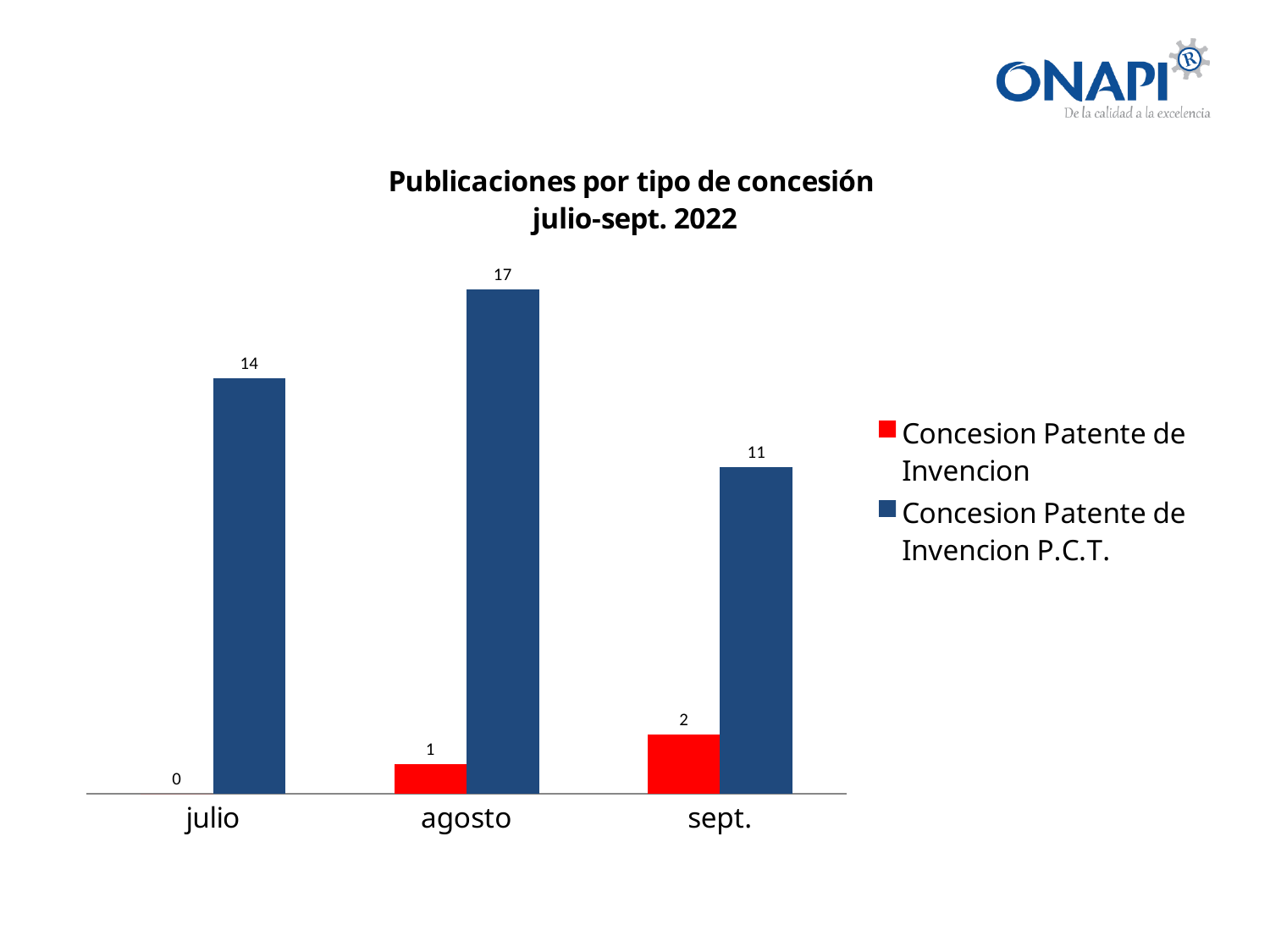
Which month has the lowest value for Concesion Patente de Invencion P.C.T.? sept. What is the difference between the Concesion Patente de Invencion P.C.T. values for agosto and sept.? 6 What colour represents Concesion Patente de Invencion in the chart? red What is the value for Concesion Patente de Invencion in julio? 0 How many months are shown on the x axis? 3 Which month has the highest value for Concesion Patente de Invencion P.C.T.? agosto What kind of chart is shown on the slide? bar chart What is the value for Concesion Patente de Invencion P.C.T. in agosto? 17 What is the value for Concesion Patente de Invencion in sept.? 2 What is the value for Concesion Patente de Invencion P.C.T. in julio? 14 Which is larger in sept.: Concesion Patente de Invencion or Concesion Patente de Invencion P.C.T.? Concesion Patente de Invencion P.C.T. How many series does the legend list? 2